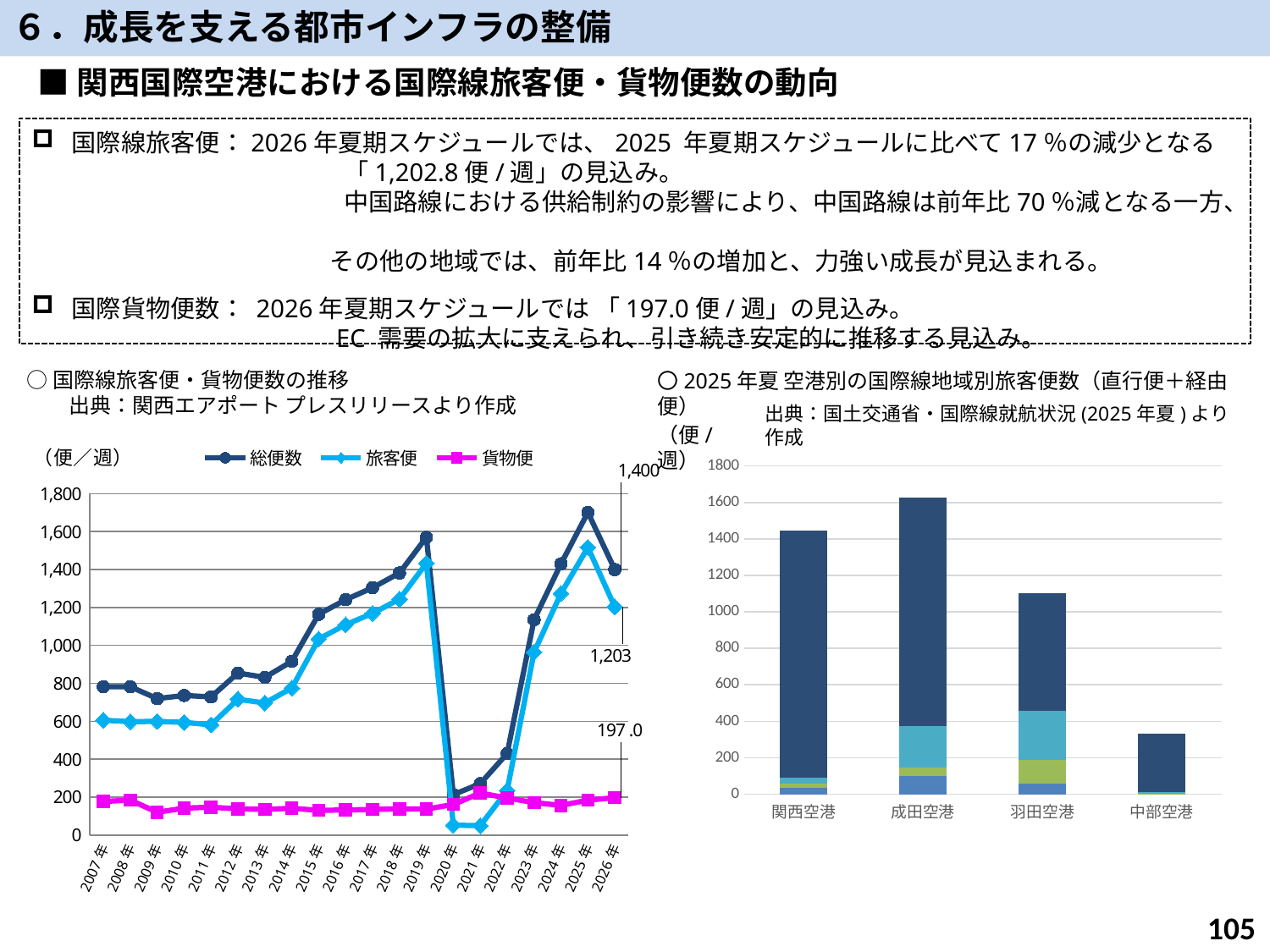
In the right chart (2025年夏 空港別の国際線地域別旅客便数), which airport has the highest total? 成田空港 In the left chart (国際線旅客便・貨物便数の推移), what is the value of 総便数 for 2026年? 1,400 In the left chart (国際線旅客便・貨物便数の推移), how many years are shown on the x axis? 20 In the left chart (国際線旅客便・貨物便数の推移), which is larger, 総便数 for 2025年 or 総便数 for 2026年? 2025年 In the right chart (2025年夏 空港別の国際線地域別旅客便数), which airport has the lowest total? 中部空港 In the right chart (2025年夏 空港別の国際線地域別旅客便数), is the total for 羽田空港 greater or less than 1200? less In the left chart (国際線旅客便・貨物便数の推移), how many series does the legend list? 3 In the left chart (国際線旅客便・貨物便数の推移), is the value of 旅客便 for 2020年 greater or less than 200? less In the left chart (国際線旅客便・貨物便数の推移), what is the value of 旅客便 for 2026年? 1,203 What kind of chart is the left chart, 国際線旅客便・貨物便数の推移? line chart In the left chart (国際線旅客便・貨物便数の推移), what is the value of 貨物便 for 2026年? 197.0 What kind of chart is the right chart, 2025年夏 空港別の国際線地域別旅客便数? bar chart